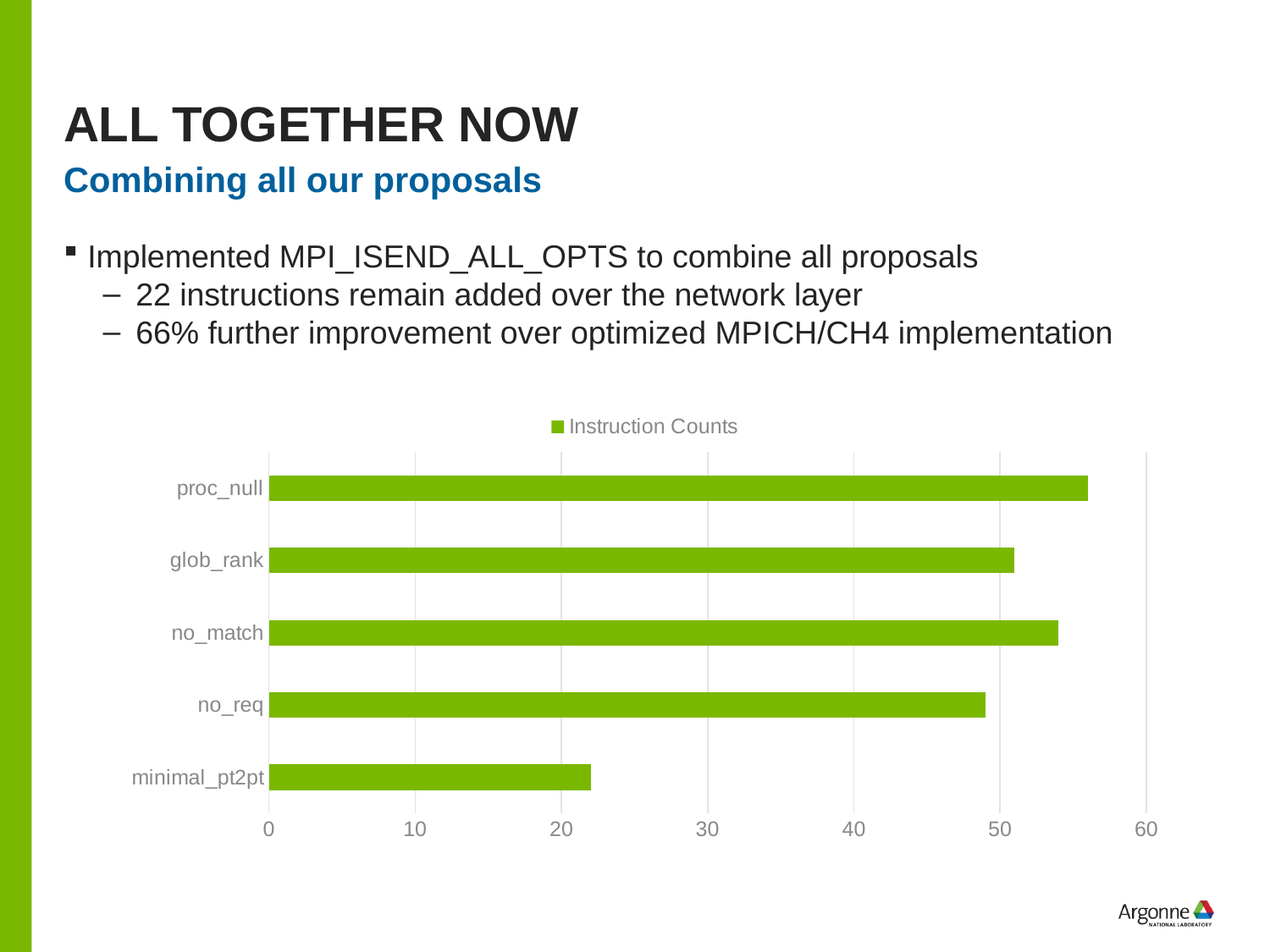
How many series does the chart legend list? 1 Which category has the highest instruction count? proc_null How many categories are plotted in the chart? 5 Which category has the lowest instruction count? minimal_pt2pt What kind of chart is shown on the slide? bar chart Is the value for minimal_pt2pt greater or less than 30? less Is the value for no_match greater or less than 50? greater What is the name of the series shown in the chart legend? Instruction Counts Is the value for proc_null greater or less than 50? greater Which has a larger instruction count, proc_null or glob_rank? proc_null Which has a larger instruction count, no_req or no_match? no_match